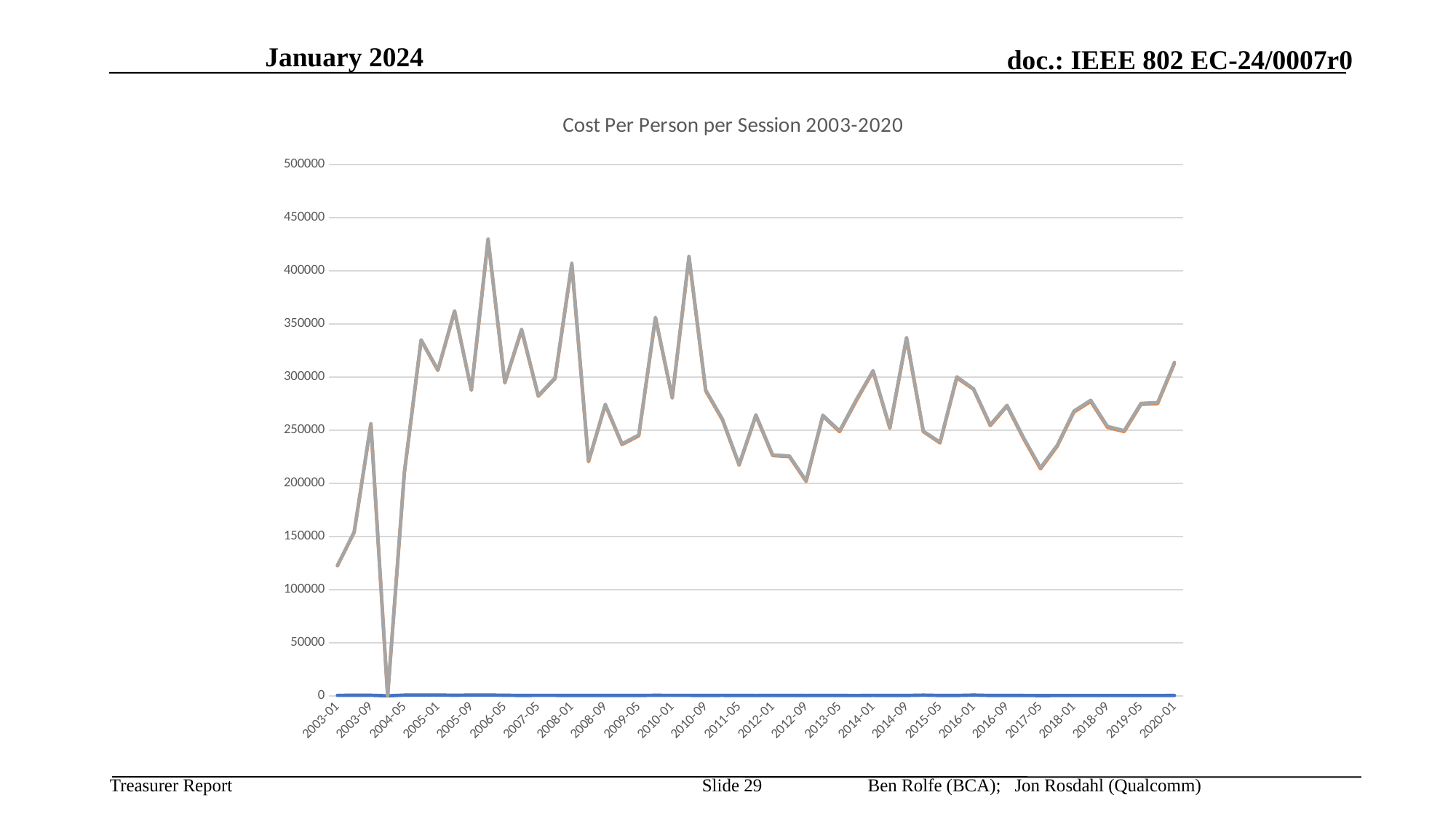
Does the line rise or fall from 2019-05 to 2020-01? rise What is the title of the chart? Cost Per Person per Session 2003-2020 What kind of chart is shown on the slide? line chart Is the value for 2020-01 greater or less than 300000? greater Is the value for 2011-05 greater or less than 250000? less Is the value for 2008-01 greater or less than 350000? greater Which has the larger value, 2008-01 or 2008-09? 2008-01 Which has the larger value, 2020-01 or 2003-01? 2020-01